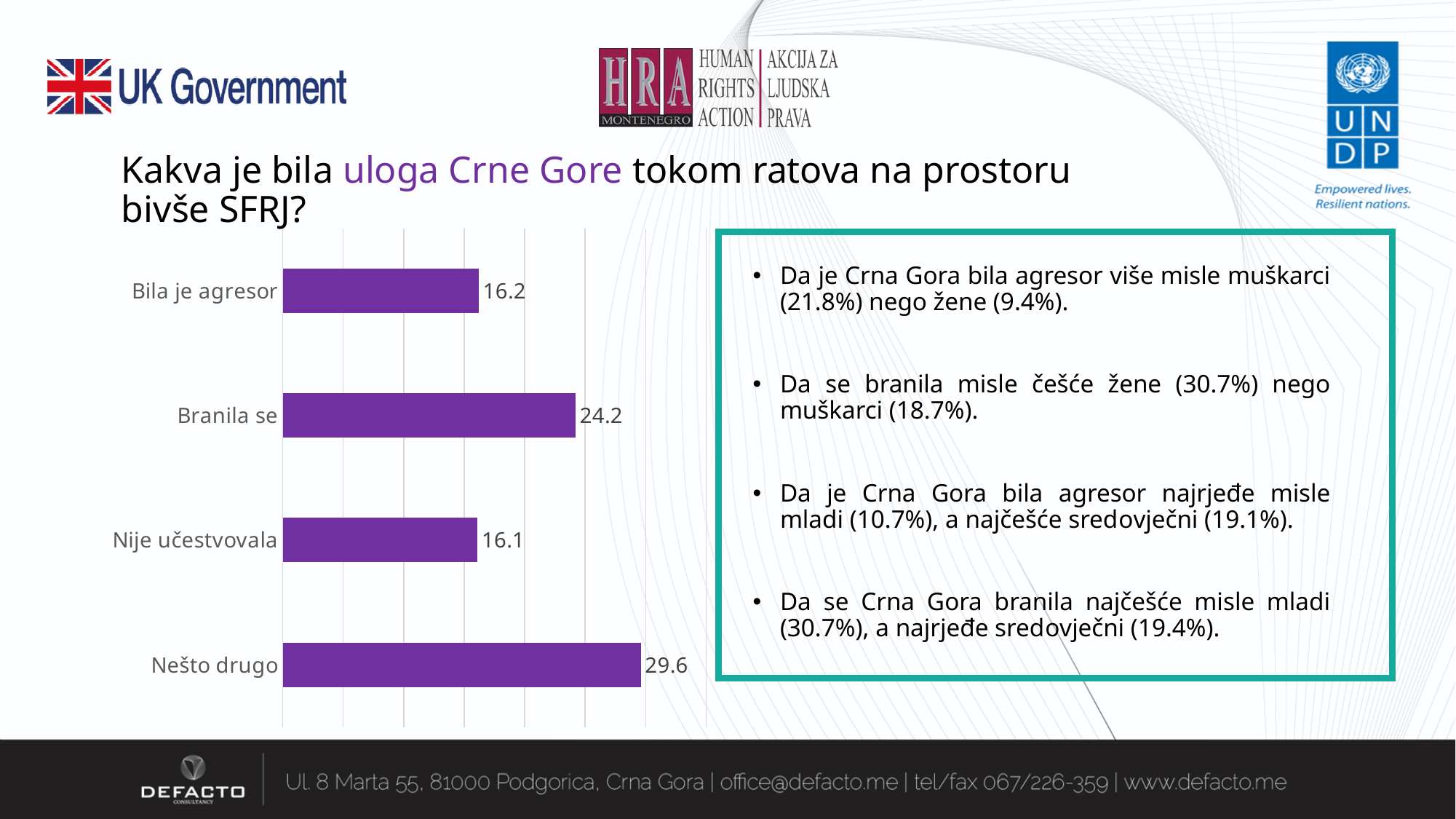
What is the value for "Branila se"? 24.2 What is the value for "Nešto drugo"? 29.6 What kind of chart is shown on the slide? Bar chart What is the difference between the values for "Branila se" and "Bila je agresor"? 8 Which category has the lowest value? Nije učestvovala What is the value for "Nije učestvovala"? 16.1 What is the difference between the values for "Nešto drugo" and "Branila se"? 5.4 How many categories are shown in the chart? 4 Which category has the highest value? Nešto drugo What is the value for "Bila je agresor"? 16.2 Which is larger, the value for "Branila se" or the value for "Nije učestvovala"? Branila se What colour are the bars in the chart? Purple